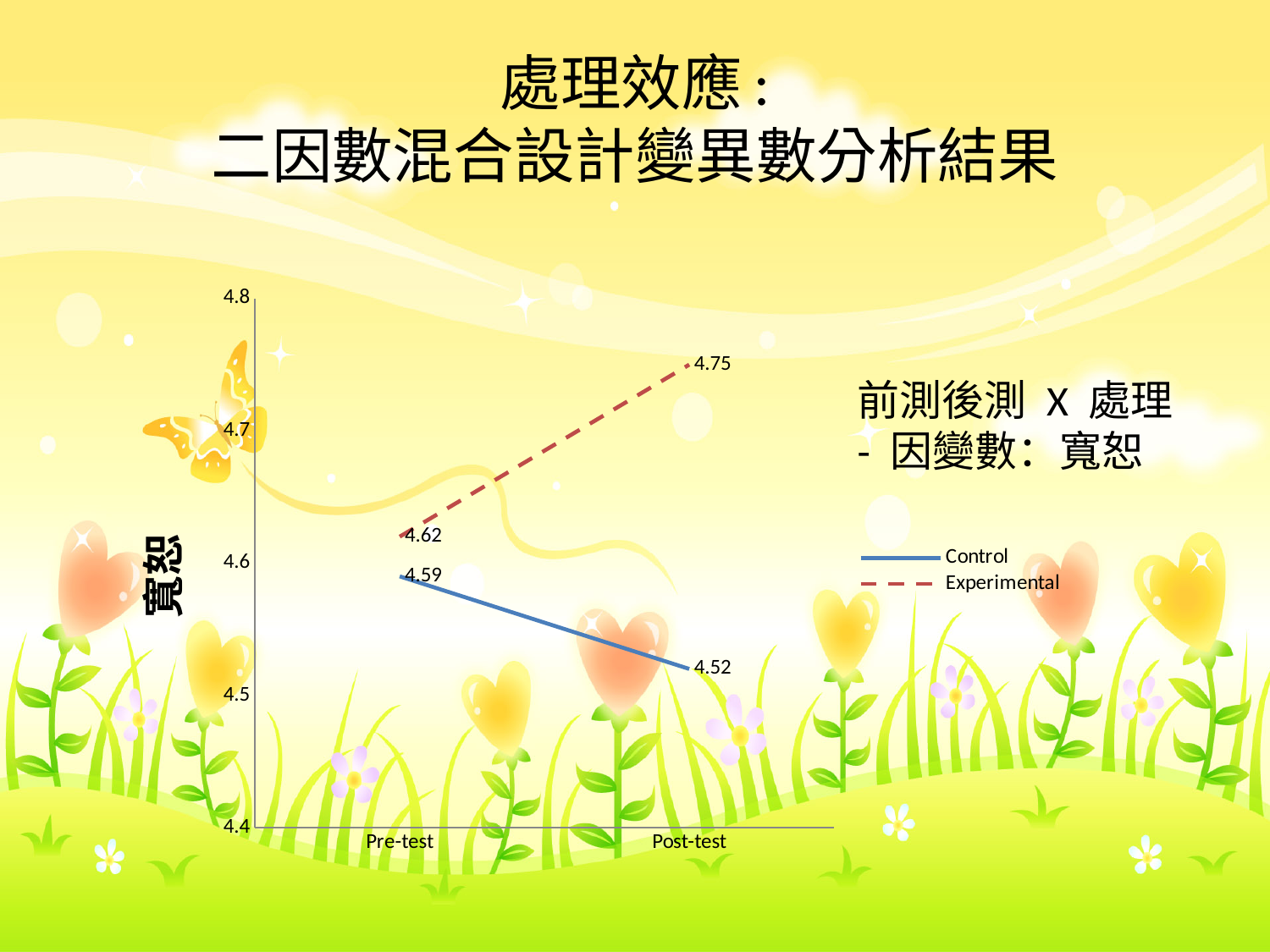
How many series does the legend list? 2 What is the value for the Control group at Pre-test? 4.59 Does the Control group's value rise or fall from Pre-test to Post-test? Fall Which group has the higher value at Post-test, Control or Experimental? Experimental Which series is drawn with a dashed line? Experimental What is the value for the Control group at Post-test? 4.52 Does the Experimental group's value rise or fall from Pre-test to Post-test? Rise What is the value for the Experimental group at Pre-test? 4.62 What is the value for the Experimental group at Post-test? 4.75 What is the difference between the Experimental and Control groups at Post-test? 0.23 What is the difference between the Experimental group's Post-test and Pre-test values? 0.13 What kind of chart is shown on the slide? Line chart